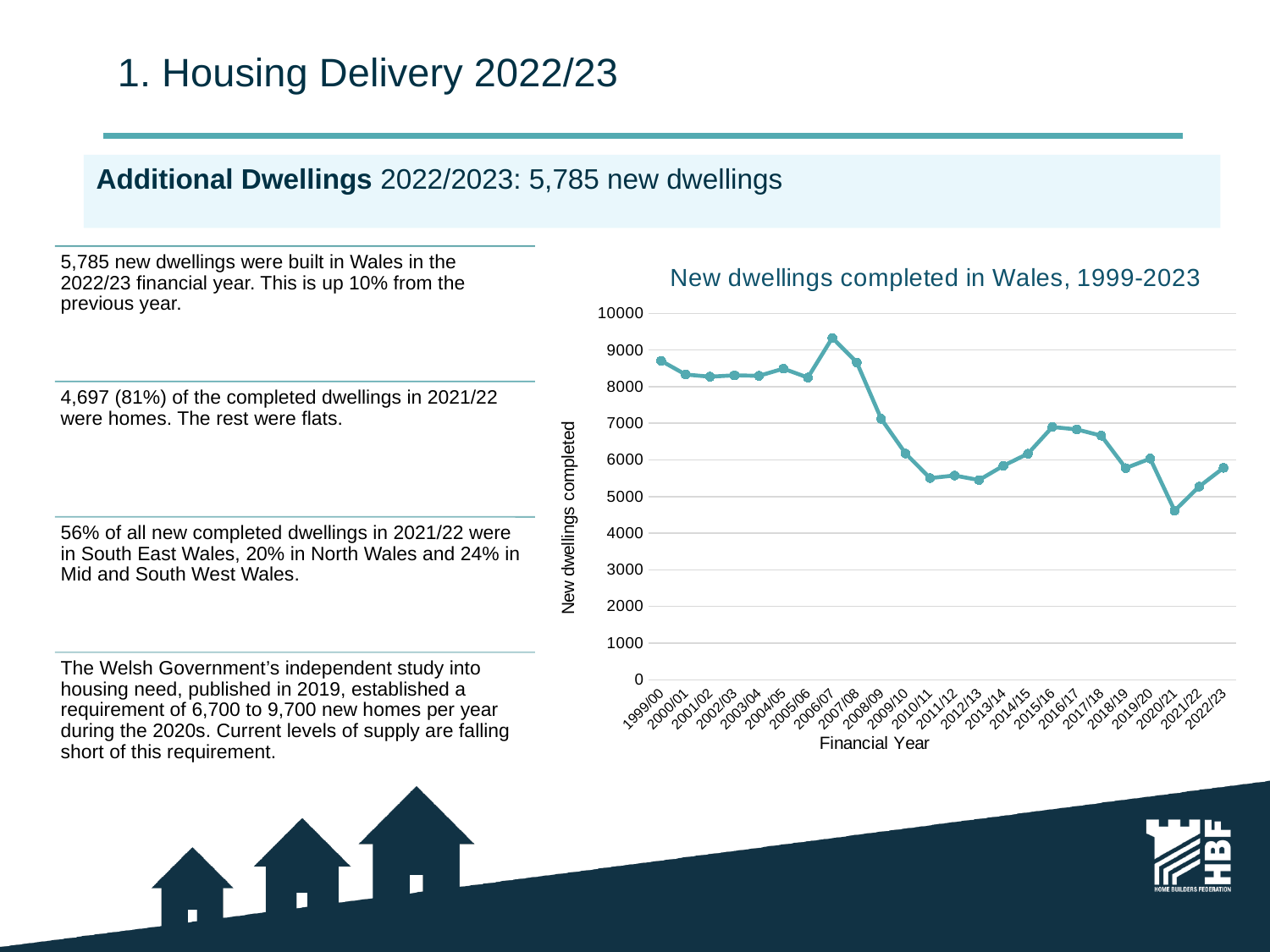
What type of chart is shown on the slide? line chart Is the value for 2018/19 greater or less than 6000? less Which financial year has the highest number of new dwellings completed? 2006/07 Is the value for 2020/21 greater or less than 5000? less What is the label of the x axis of the chart? Financial Year Which financial year has the lowest number of new dwellings completed? 2020/21 What is the title of the chart? New dwellings completed in Wales, 1999-2023 How many financial years are plotted on the chart? 24 Which is larger, the value for 1999/00 or the value for 2022/23? 1999/00 Do the values rise or fall between 2007/08 and 2010/11? fall Is the value for 1999/00 greater or less than 8000? greater